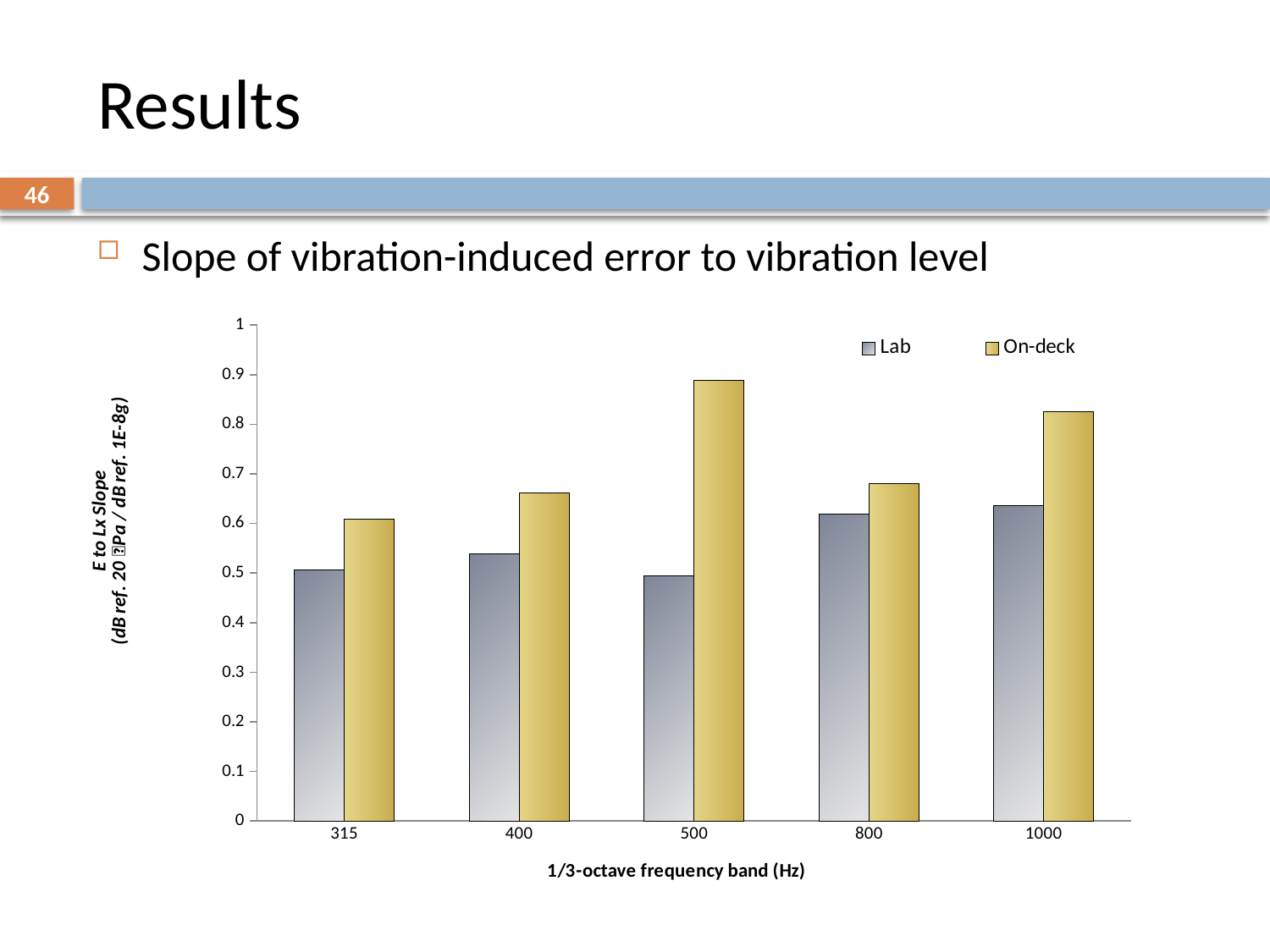
Is the On-deck value at 400 Hz greater or less than 0.7? less Is the Lab value at 400 Hz greater or less than 0.6? less How many frequency bands are shown on the x axis? 5 Is the Lab value at 315 Hz greater or less than 0.6? less Which series has the larger value at 1000 Hz, Lab or On-deck? On-deck What is the title of the x axis? 1/3-octave frequency band (Hz) At 500 Hz, which series has the larger value, Lab or On-deck? On-deck Which frequency band has the highest On-deck value? 500 What kind of chart is shown on the slide? bar chart Which frequency band has the lowest On-deck value? 315 How many series does the legend list? 2